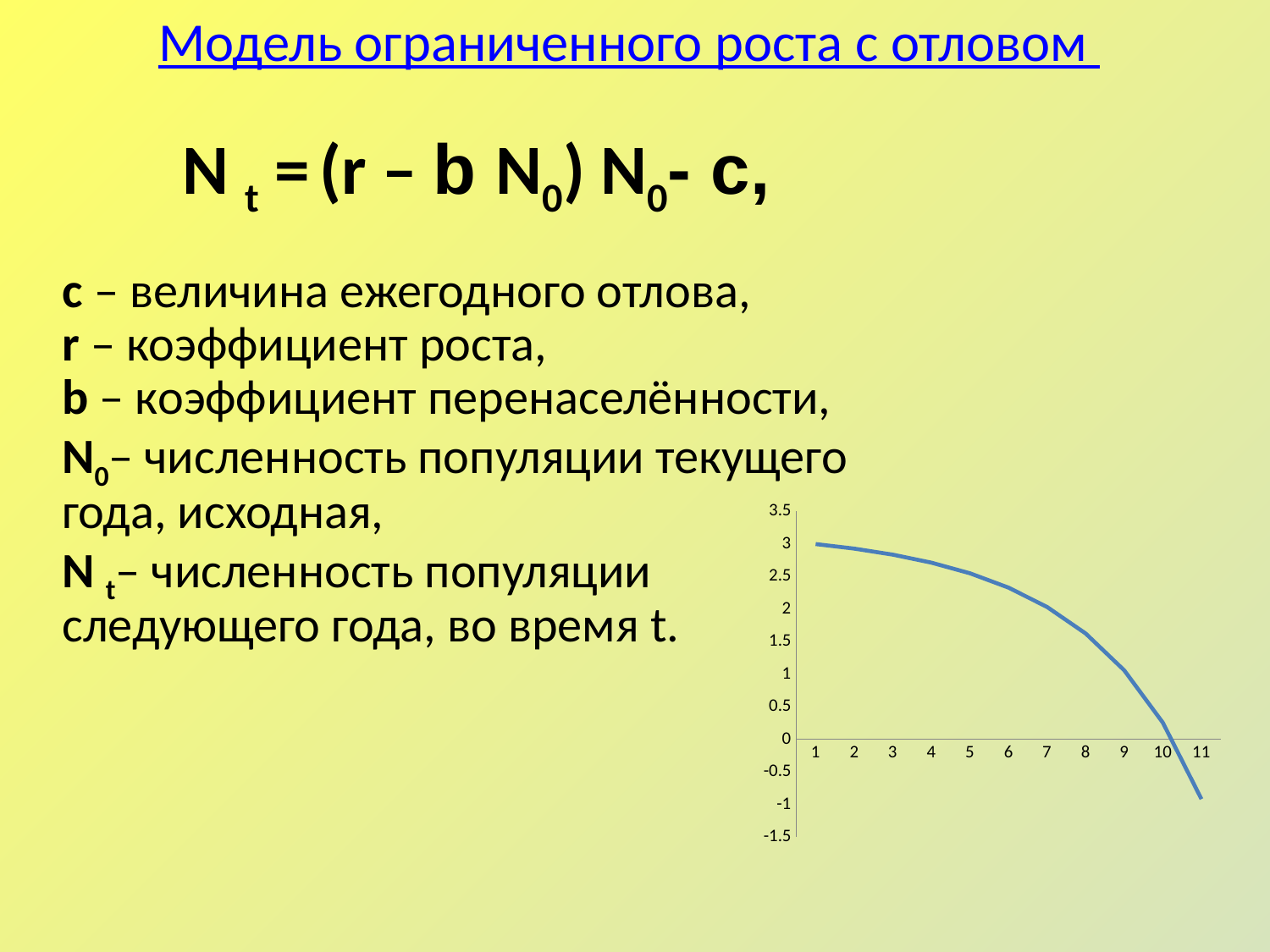
Is the value at x = 5 greater or less than 2? greater Is the value at x = 3 greater or less than 2.5? greater What kind of chart is shown on the slide? line chart At which x value is the plotted line highest? 1 How many x-axis points (1 to 11) are labelled on the chart? 11 Do the values on the chart rise or fall as x increases from 1 to 11? fall How many lines are plotted on the chart? 1 At which x value is the plotted line lowest? 11 Is the value at x = 9 greater or less than 1.5? less What is the highest tick label shown on the y axis of the chart? 3.5 Which is larger, the value at x = 2 or the value at x = 8? x = 2